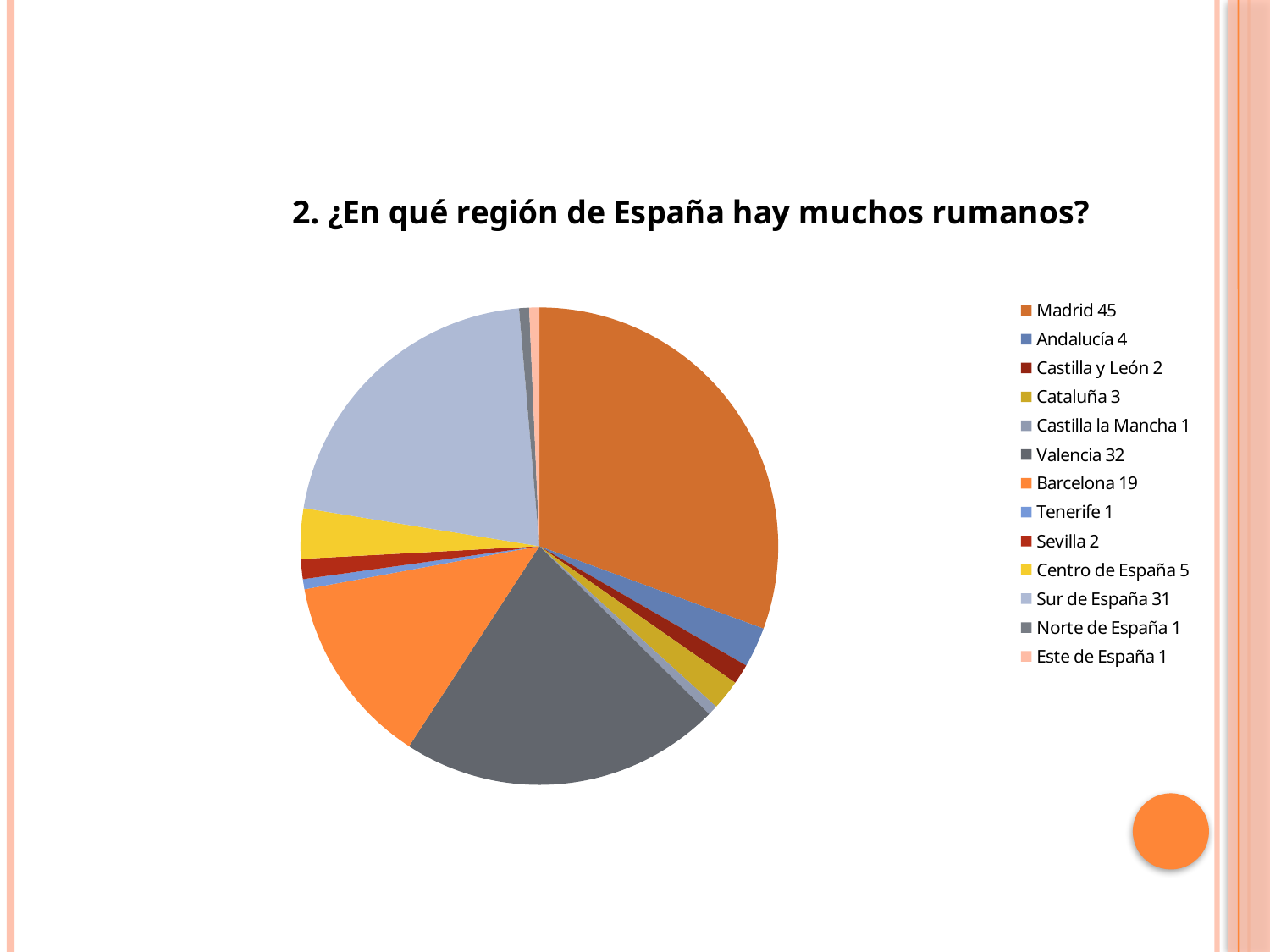
What is the value for Sur de España in the pie chart? 31 What is the value for Valencia in the pie chart? 32 What is the difference between the values for Barcelona and Andalucía? 15 Which is larger, the value for Valencia or the value for Barcelona? Valencia Which region has the largest slice in the pie chart? Madrid How many categories does the pie chart legend list? 13 What is the value for Madrid in the pie chart? 45 What is the value for Barcelona in the pie chart? 19 What type of chart is shown on the slide? pie chart What is the title of the chart? 2. ¿En qué región de España hay muchos rumanos? What is the value for Centro de España in the pie chart? 5 What is the difference between the values for Madrid and Valencia? 13